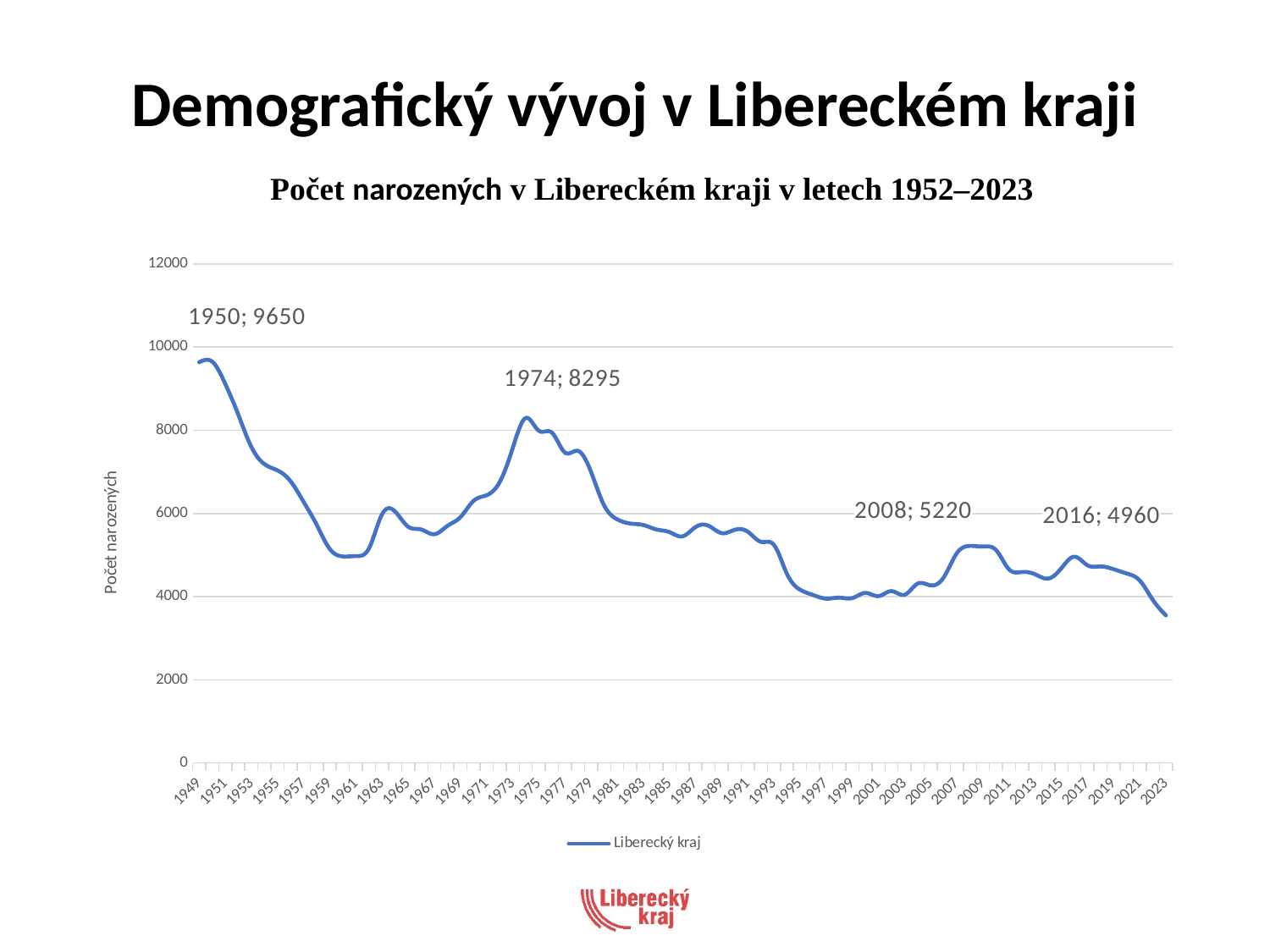
What kind of chart is shown on the slide? line chart What is the value shown for 2008? 5220 What is the difference between the values for 2008 and 2016? 260 How many series does the legend list? 1 What is the value shown for 1950? 9650 Is the value for 1960 greater or less than 6000? less What is the value shown for 2016? 4960 What is the difference between the values for 1950 and 1974? 1355 Which year has the higher value, 1974 or 2008? 1974 What is the value shown for 1974? 8295 Is the value for 2023 greater or less than 4000? less Which year has the highest value on the chart? 1950